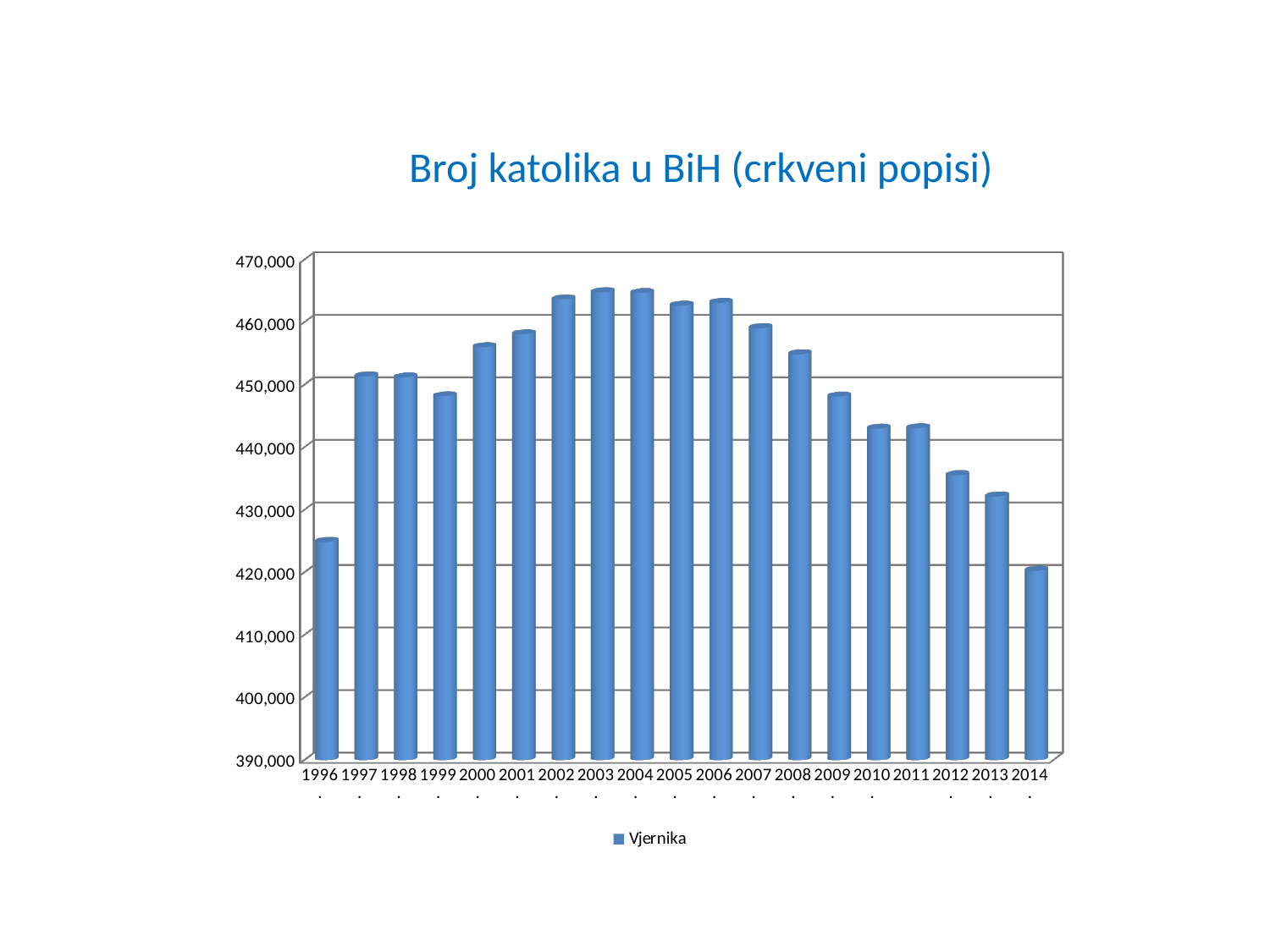
How many series does the legend list? 1 Is the value for 2003 greater or less than 460,000? greater Is the value for 2014 greater or less than 430,000? less What is the title of the chart? Broj katolika u BiH (crkveni popisi) Which year has the lowest value? 2014 What is the name of the series shown in the legend? Vjernika Is the value for 2000 greater or less than 450,000? greater Which is larger, the value for 2007 or the value for 2013? 2007 How many years are shown on the x axis? 19 What kind of chart is shown on the slide? bar chart Do the values rise or fall from 2006 to 2014? fall